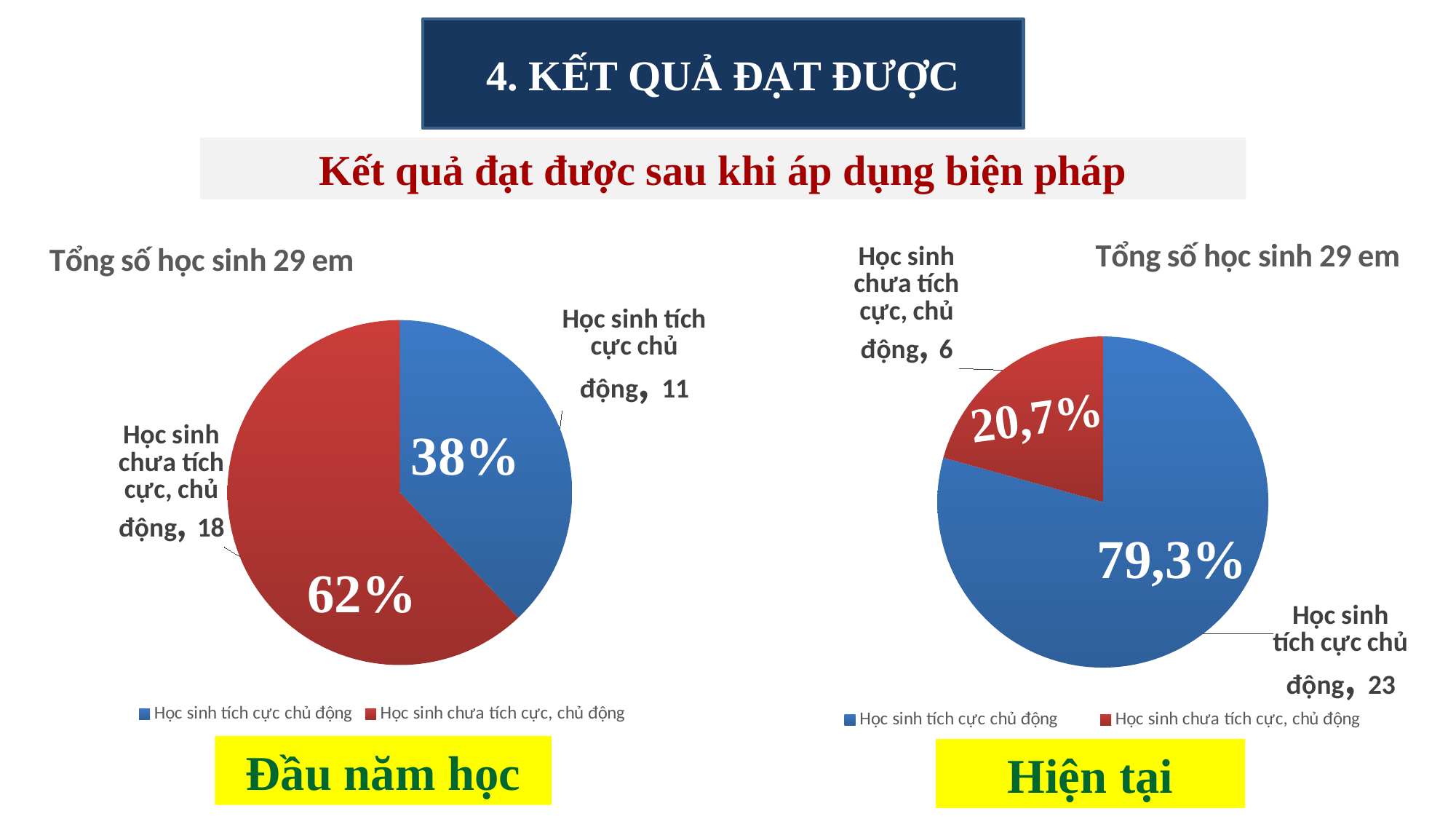
In the right pie chart (Hiện tại), how many students are in the 'Học sinh tích cực chủ động' category? 23 What is the difference between the number of 'Học sinh tích cực chủ động' in the right chart (Hiện tại) and in the left chart (Đầu năm học)? 12 In the left pie chart (Đầu năm học), which category is the smallest? Học sinh tích cực chủ động In the left pie chart (Đầu năm học), how many students are in the 'Học sinh tích cực chủ động' category? 11 How many entries does the legend of the right pie chart (Hiện tại) list? 2 What kind of chart is shown on the left side of the slide (Đầu năm học)? pie chart In the left pie chart (Đầu năm học), what percentage share does 'Học sinh tích cực chủ động' have? 38% In the right pie chart (Hiện tại), what percentage share does 'Học sinh tích cực chủ động' have? 79,3% In the right pie chart (Hiện tại), which category is the largest? Học sinh tích cực chủ động In the right pie chart (Hiện tại), how many students are in the 'Học sinh chưa tích cực, chủ động' category? 6 In the left pie chart (Đầu năm học), how many students are in the 'Học sinh chưa tích cực, chủ động' category? 18 In the left pie chart (Đầu năm học), what percentage share does 'Học sinh chưa tích cực, chủ động' have? 62%